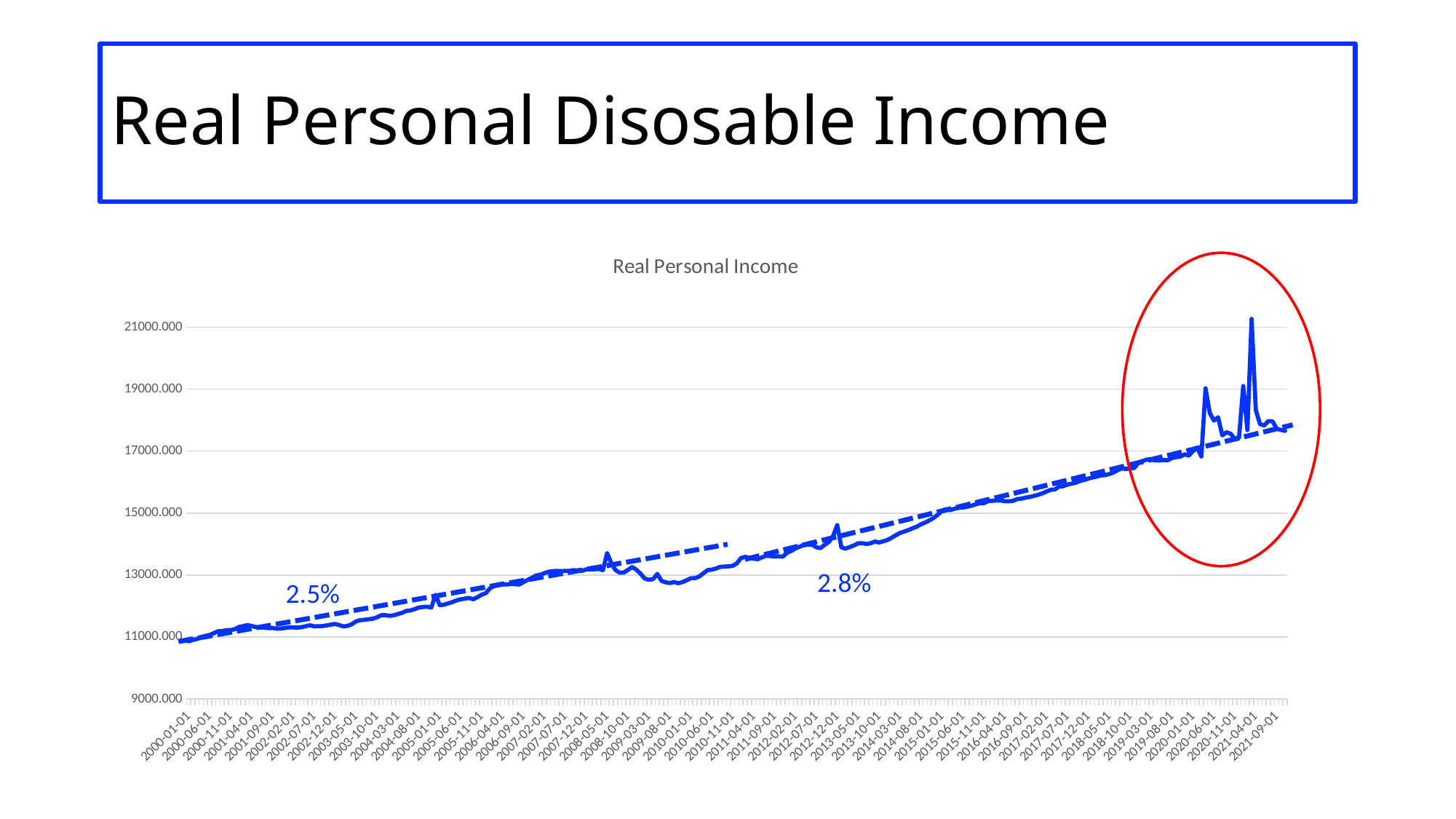
Is the value at 2000-01-01 greater or less than 13000.000? less Do the values in the Real Personal Income chart generally rise or fall from 2000 to 2021? rise Is the value at 2021-09-01 greater or less than 17000.000? greater Which is larger, the value at 2021-09-01 or the value at 2000-01-01? 2021-09-01 What growth rate is annotated next to the right dashed trend line? 2.8% Is the value at 2017-02-01 greater or less than 15000.000? greater What growth rate is annotated next to the left dashed trend line? 2.5% In which year does the series reach its highest value? 2021 What kind of chart is shown on the slide? line chart